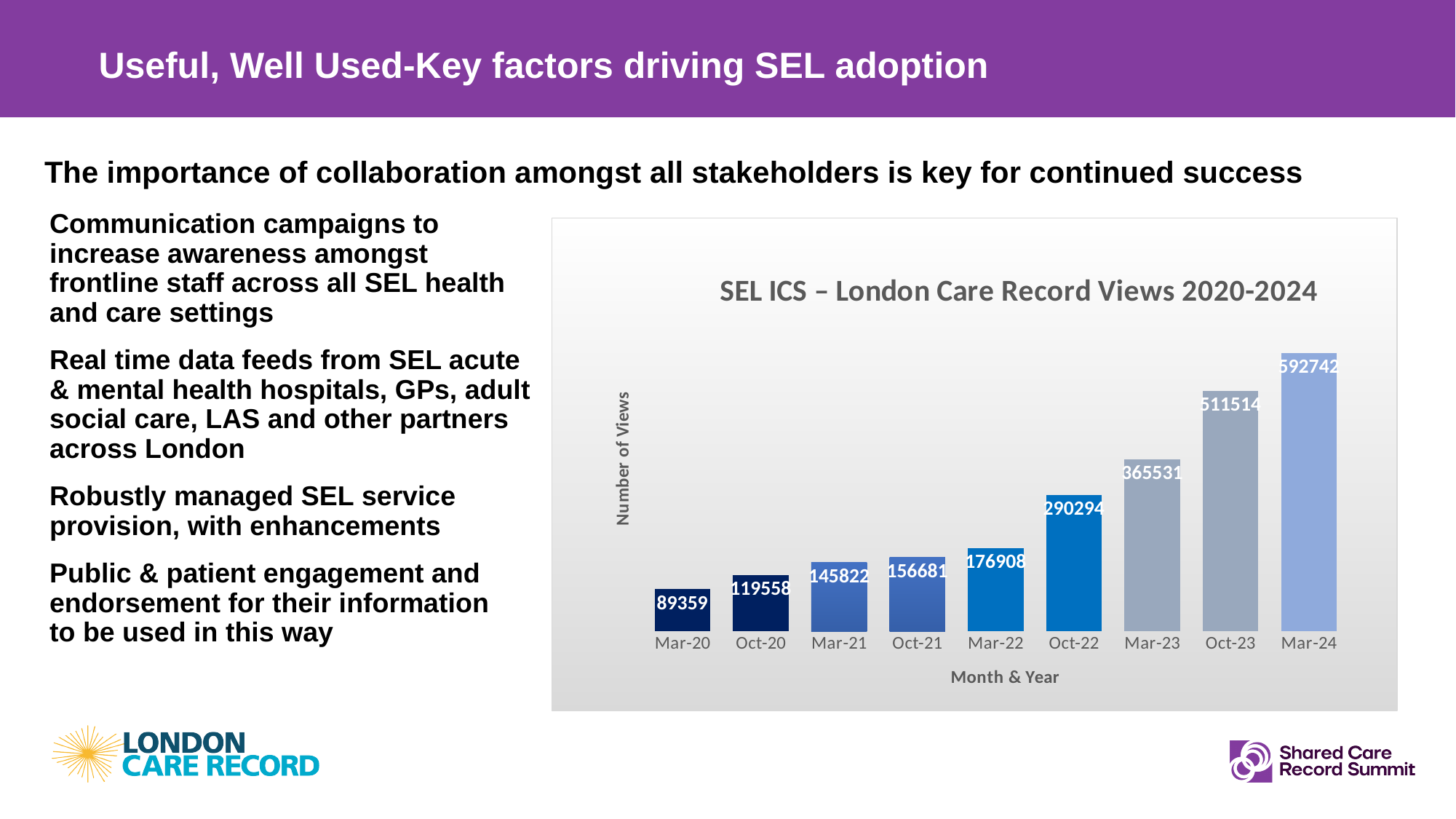
What is the number of views for Mar-20? 89359 Which month and year has the highest number of views? Mar-24 What kind of chart is shown on the slide? Bar chart How many months are shown on the x axis of the chart? 9 What is the number of views for Oct-22? 290294 What is the difference in views between Oct-22 and Mar-22? 113386 What is the number of views for Mar-23? 365531 Which month and year has the lowest number of views? Mar-20 What is the difference in views between Mar-24 and Oct-23? 81228 What is the title of the chart? SEL ICS – London Care Record Views 2020-2024 Do the number of views rise or fall from Mar-20 to Mar-24? Rise Which has more views, Oct-21 or Mar-22? Mar-22